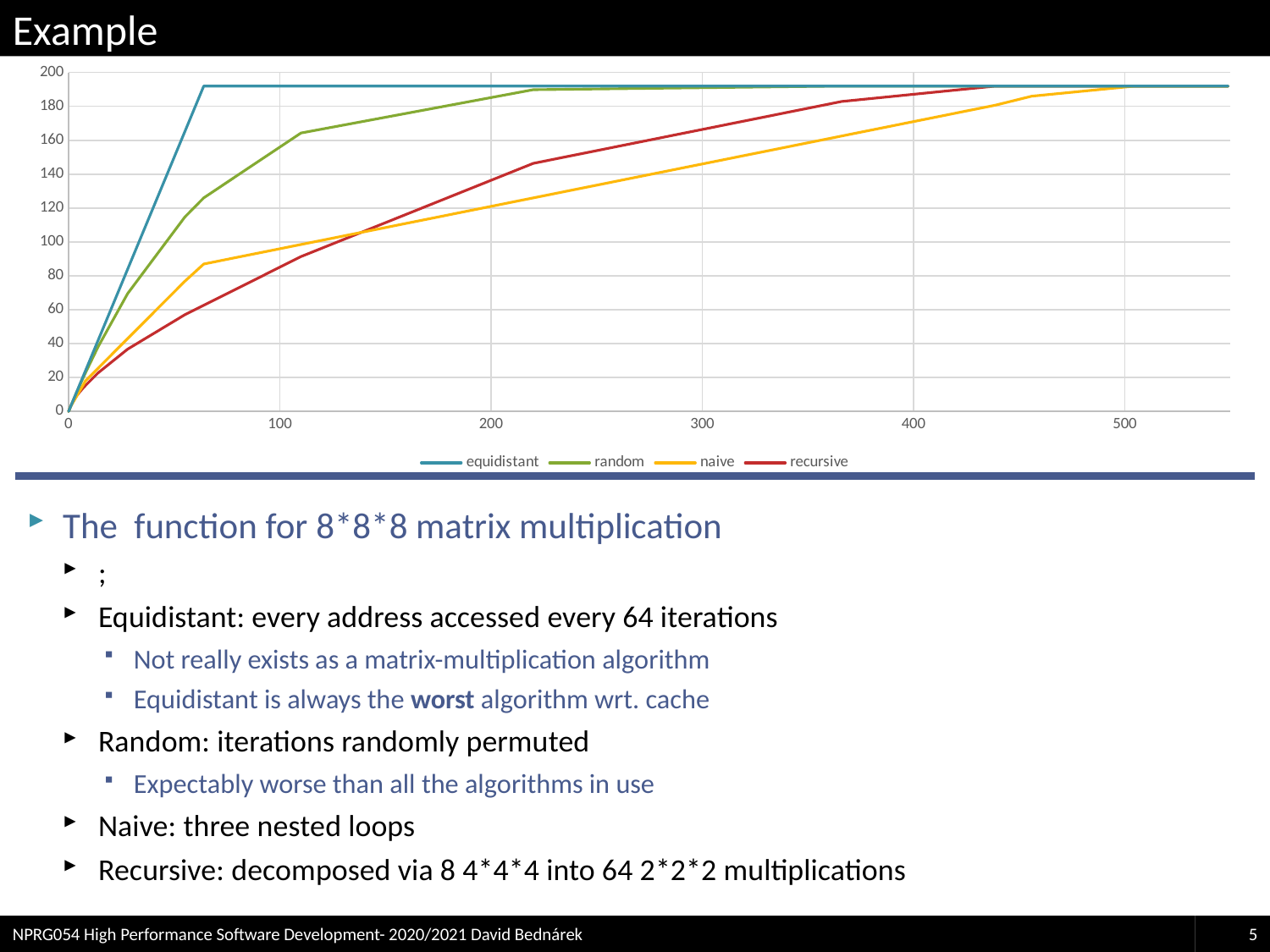
At x = 200, which series has the larger value, naive or recursive? recursive How many series does the chart legend list? 4 At x = 100, which series has the larger value, random or naive? random What colour is the line for the naive series? yellow Which series is the last to reach the top plateau along the x axis? naive Do the values of the naive series rise or fall as x increases? rise Is the value of the naive series at x = 300 greater or less than 120? greater Which series reaches the top plateau of about 190 at the smallest x value? equidistant Is the value of the recursive series at x = 100 greater or less than 100? less Is the value of the equidistant series at x = 100 greater or less than 180? greater What kind of chart is shown on the slide? line chart Which series are listed in the chart legend? equidistant, random, naive, recursive